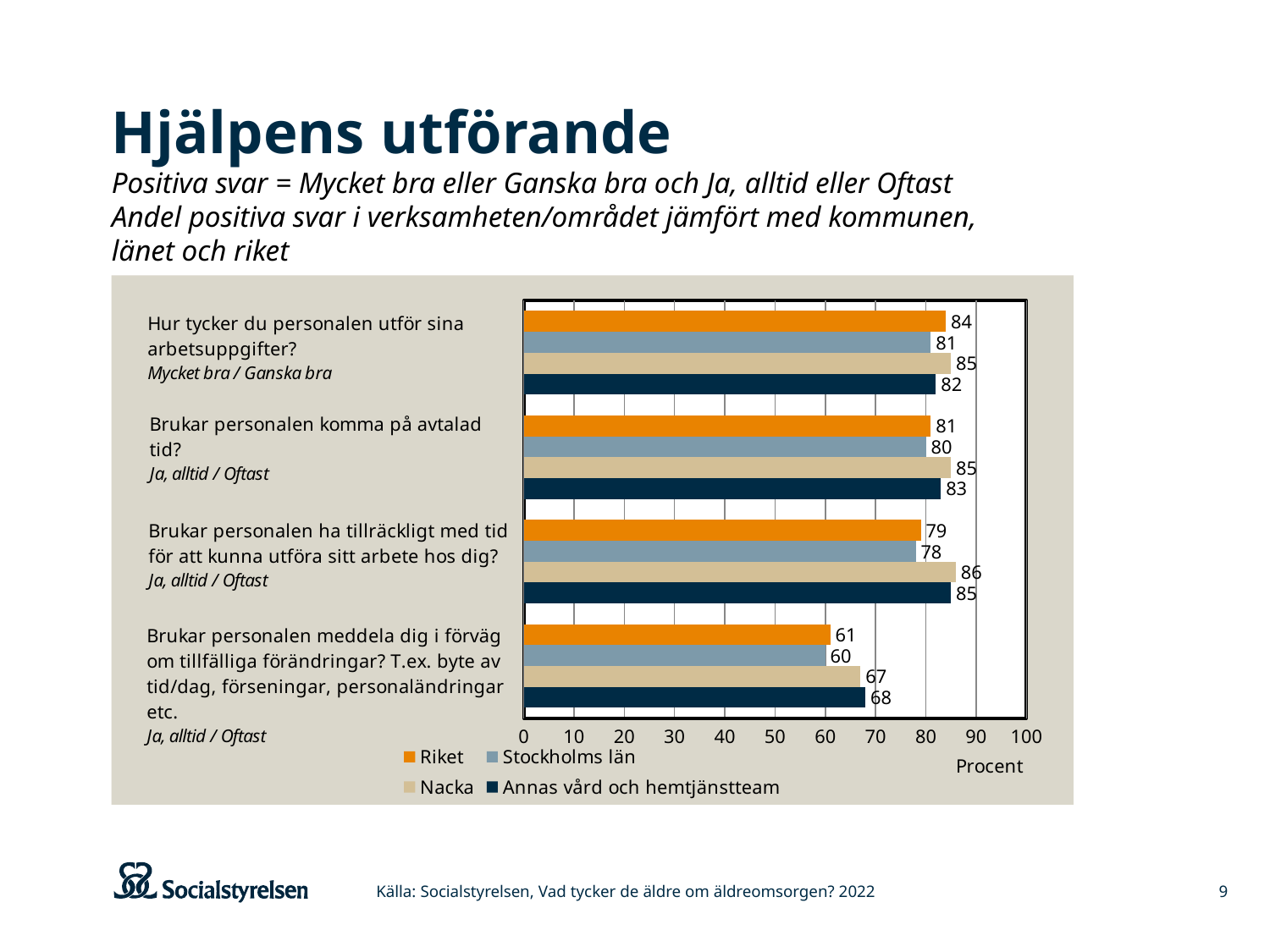
What value is shown for Riket on the question "Brukar personalen komma på avtalad tid?"? 81 Which series has the highest value on the question "Brukar personalen meddela dig i förväg om tillfälliga förändringar?"? Annas vård och hemtjänstteam What kind of chart is shown on the slide? Bar chart What is the label on the horizontal axis of the chart? Procent How many question categories are shown on the chart? 4 What value is shown for Nacka on the question "Hur tycker du personalen utför sina arbetsuppgifter?"? 85 Which series has the lowest value on the question "Brukar personalen ha tillräckligt med tid för att kunna utföra sitt arbete hos dig?"? Stockholms län What value is shown for Stockholms län on the question "Brukar personalen meddela dig i förväg om tillfälliga förändringar?"? 60 What value is shown for Annas vård och hemtjänstteam on the question "Brukar personalen ha tillräckligt med tid för att kunna utföra sitt arbete hos dig?"? 85 How many series does the legend list? 4 What is the difference between the Nacka value and the Riket value on the question "Brukar personalen ha tillräckligt med tid för att kunna utföra sitt arbete hos dig?"? 7 On the question "Brukar personalen komma på avtalad tid?", which is larger: the value for Nacka or the value for Annas vård och hemtjänstteam? Nacka